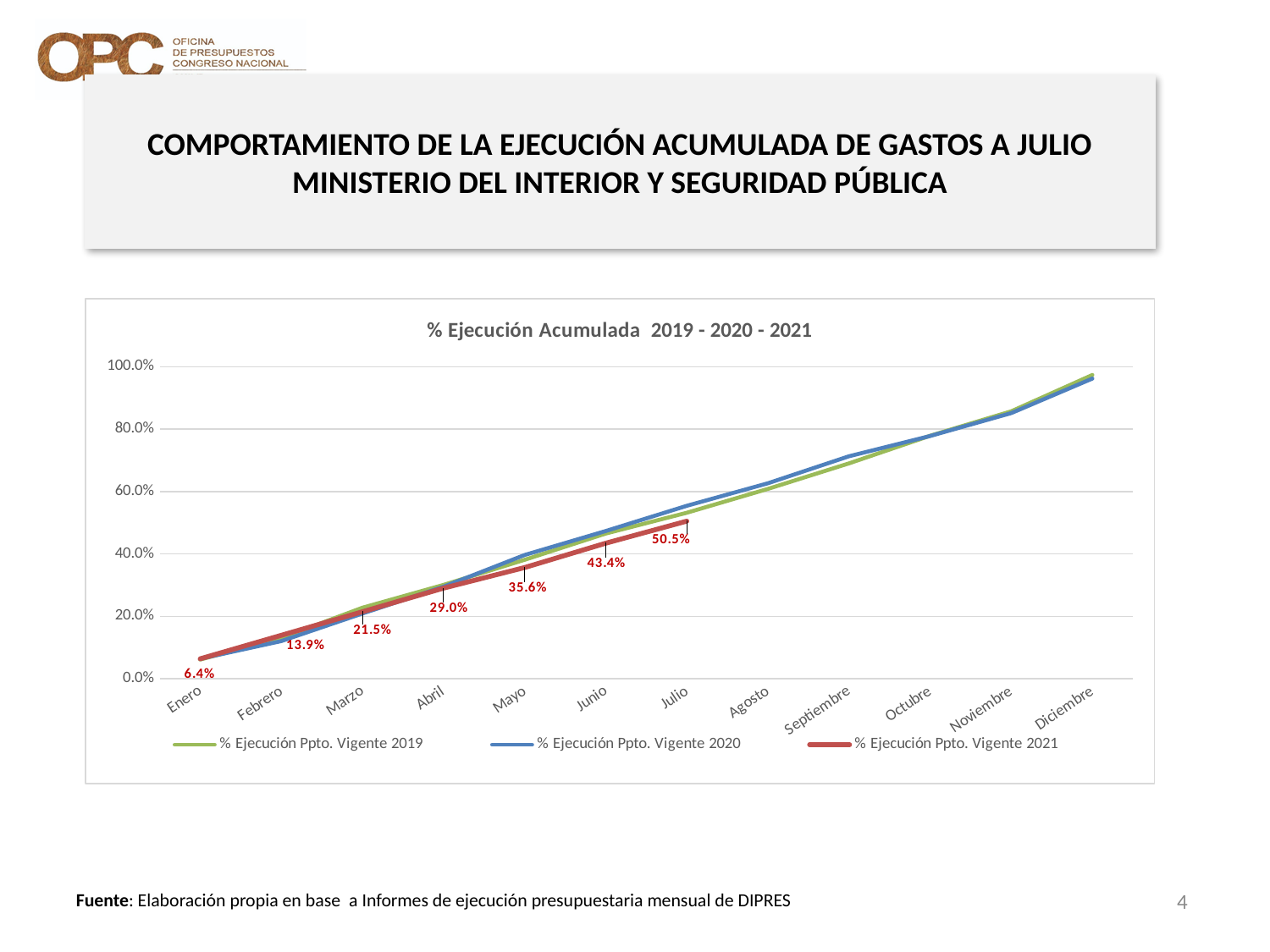
How many series does the legend list? 3 What is the value of % Ejecución Ppto. Vigente 2021 for Mayo? 35.6% What is the value of % Ejecución Ppto. Vigente 2021 for Abril? 29.0% Is the value of % Ejecución Ppto. Vigente 2020 for Diciembre greater or less than 80.0%? greater How many months are shown on the x axis? 12 What kind of chart is shown on the slide? Line chart What is the difference between the 2021 values for Julio and Junio? 7.1% What is the difference between the 2021 values for Marzo and Febrero? 7.6% Which month has the lowest value for % Ejecución Ppto. Vigente 2021? Enero What is the value of % Ejecución Ppto. Vigente 2021 for Enero? 6.4% What is the value of % Ejecución Ppto. Vigente 2021 for Julio? 50.5% Which month has the highest value for % Ejecución Ppto. Vigente 2021? Julio